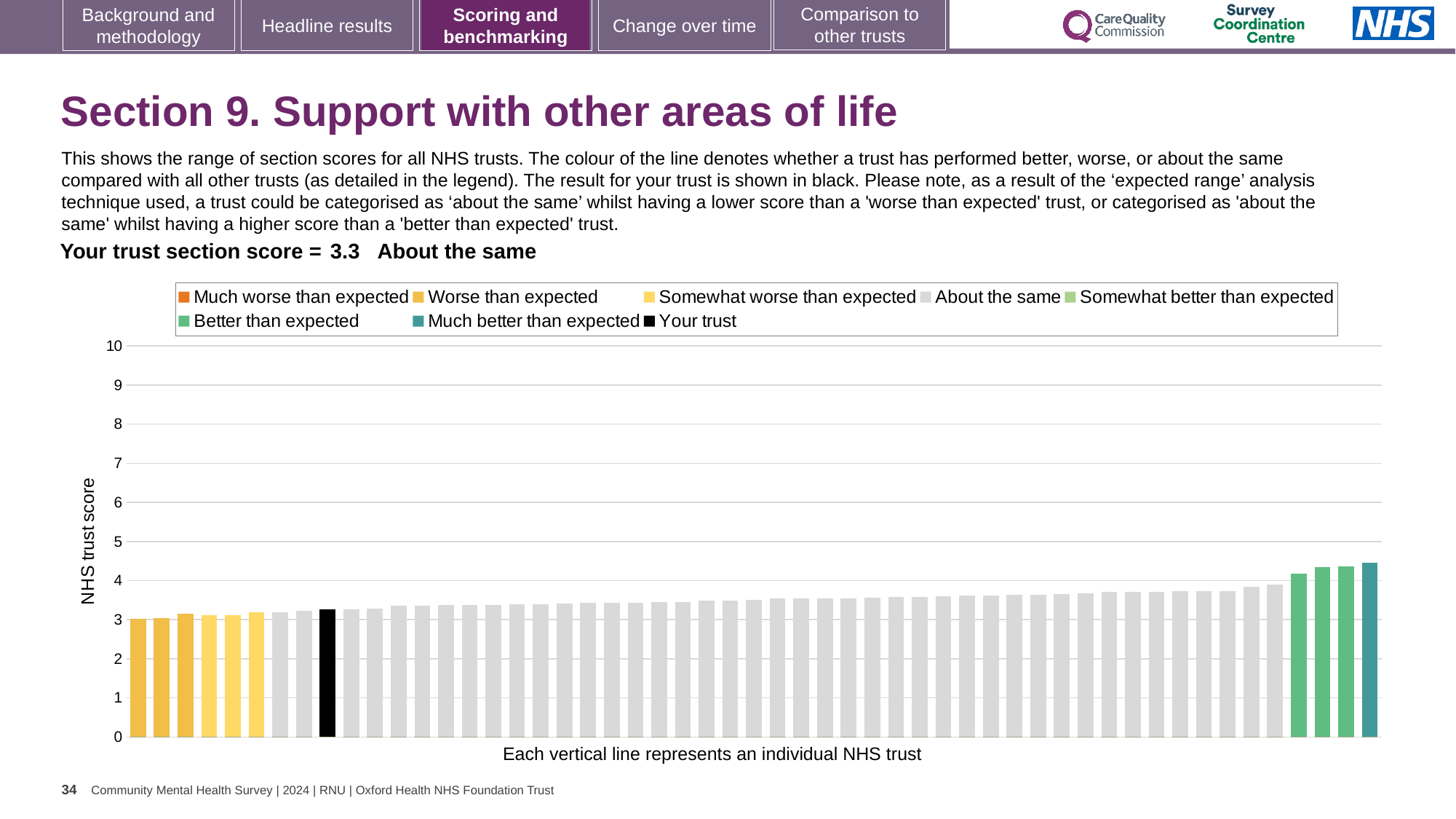
What colour is used for the bar representing your trust? black How many entries does the chart legend list? 8 What kind of chart is shown on the slide? bar chart Is the value for your trust (the black bar) greater or less than 5? less Is the black bar for your trust taller or shorter than the rightmost bar? shorter Is the value of the shortest bar greater or less than 2? greater What is the section score for your trust shown on the slide? 3.3 Is the value of the tallest bar greater or less than 4? greater What is the label on the vertical axis of the chart? NHS trust score Do the bar values rise or fall from left to right along the x axis? rise How many bars are coloured in the 'Much better than expected' colour (teal)? 1 Which category is your trust placed in for this section? About the same